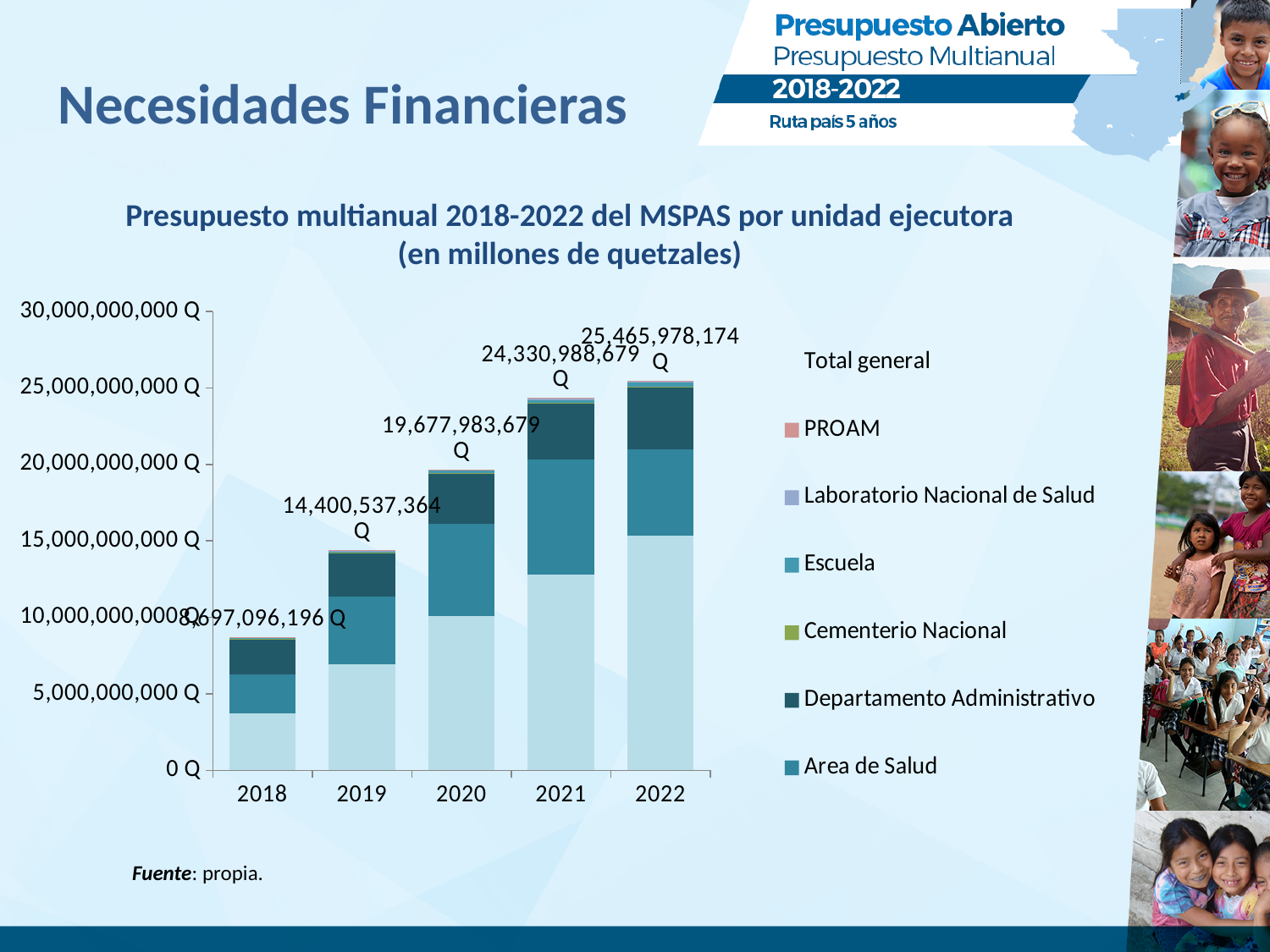
What is the total value labelled for 2022? 25,465,978,174 Q Do the totals rise or fall from 2018 to 2022? rise What is the total value labelled for 2020? 19,677,983,679 Q Which year has the highest total? 2022 Which year has the larger total, 2021 or 2020? 2021 What is the difference between the totals for 2022 and 2021? 1,134,989,495 Q How many years are shown on the x axis of the chart? 5 Which year has the lowest total? 2018 What is the total value labelled for 2019? 14,400,537,364 Q Is the Area de Salud value for 2021 greater or less than 10,000,000,000 Q? less What is the title of the chart? Presupuesto multianual 2018-2022 del MSPAS por unidad ejecutora (en millones de quetzales) What kind of chart is shown on the slide? stacked bar chart